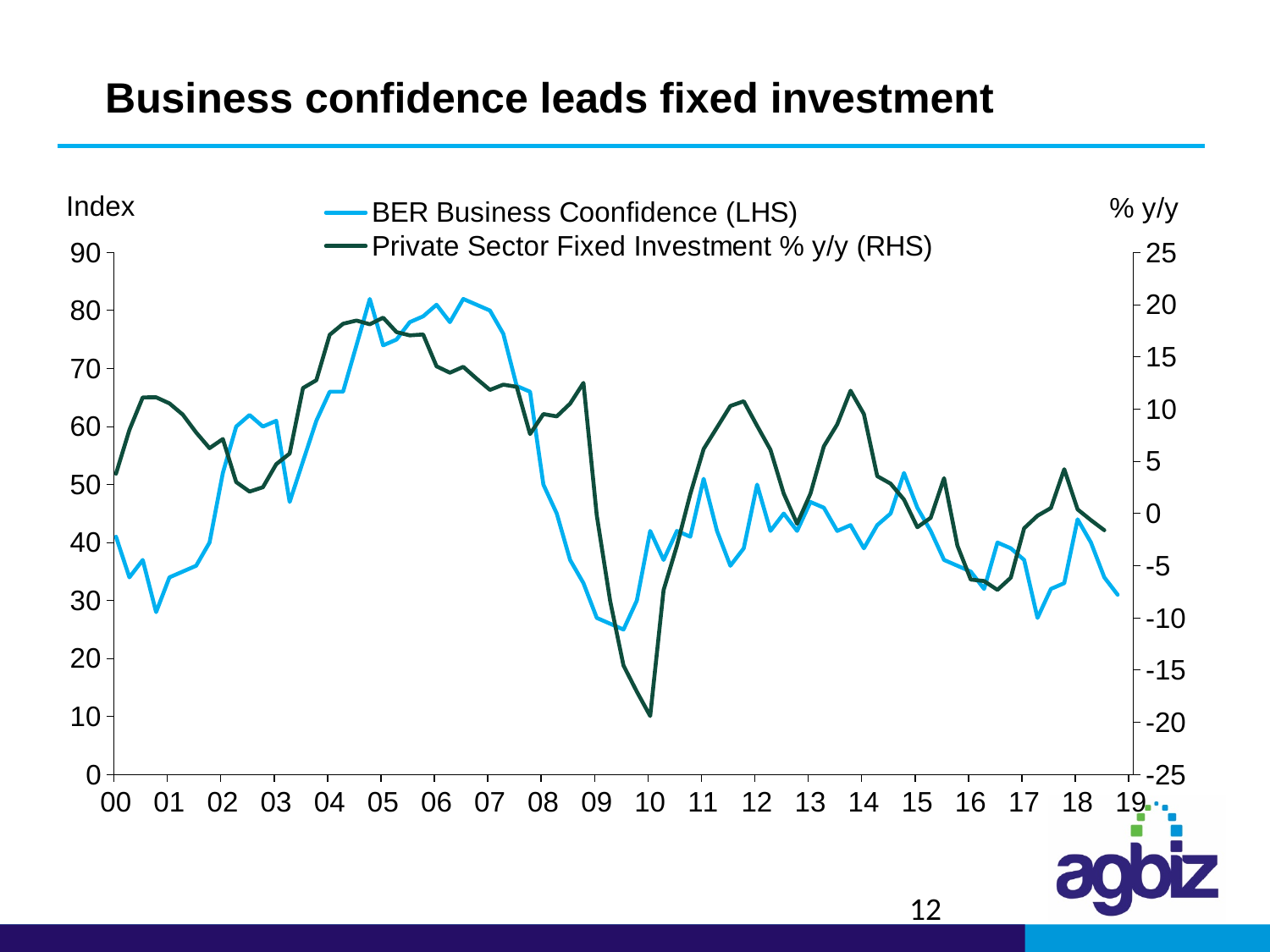
What kind of chart is shown on the slide? line chart Is the value for Private Sector Fixed Investment % y/y at its low point around 10 greater or less than -15? less Is the value for BER Business Confidence at its peak around 05 greater or less than 80? greater Is the value for BER Business Confidence at its low point around 09-10 greater or less than 30? less Which series is plotted on the right-hand axis (RHS)? Private Sector Fixed Investment % y/y What is the title of the chart? Business confidence leads fixed investment How many series does the legend list? 2 Around which year does Private Sector Fixed Investment % y/y reach its lowest value? 10 Does BER Business Confidence rise or fall between 18 and 19? fall How many year labels are shown along the x axis? 20